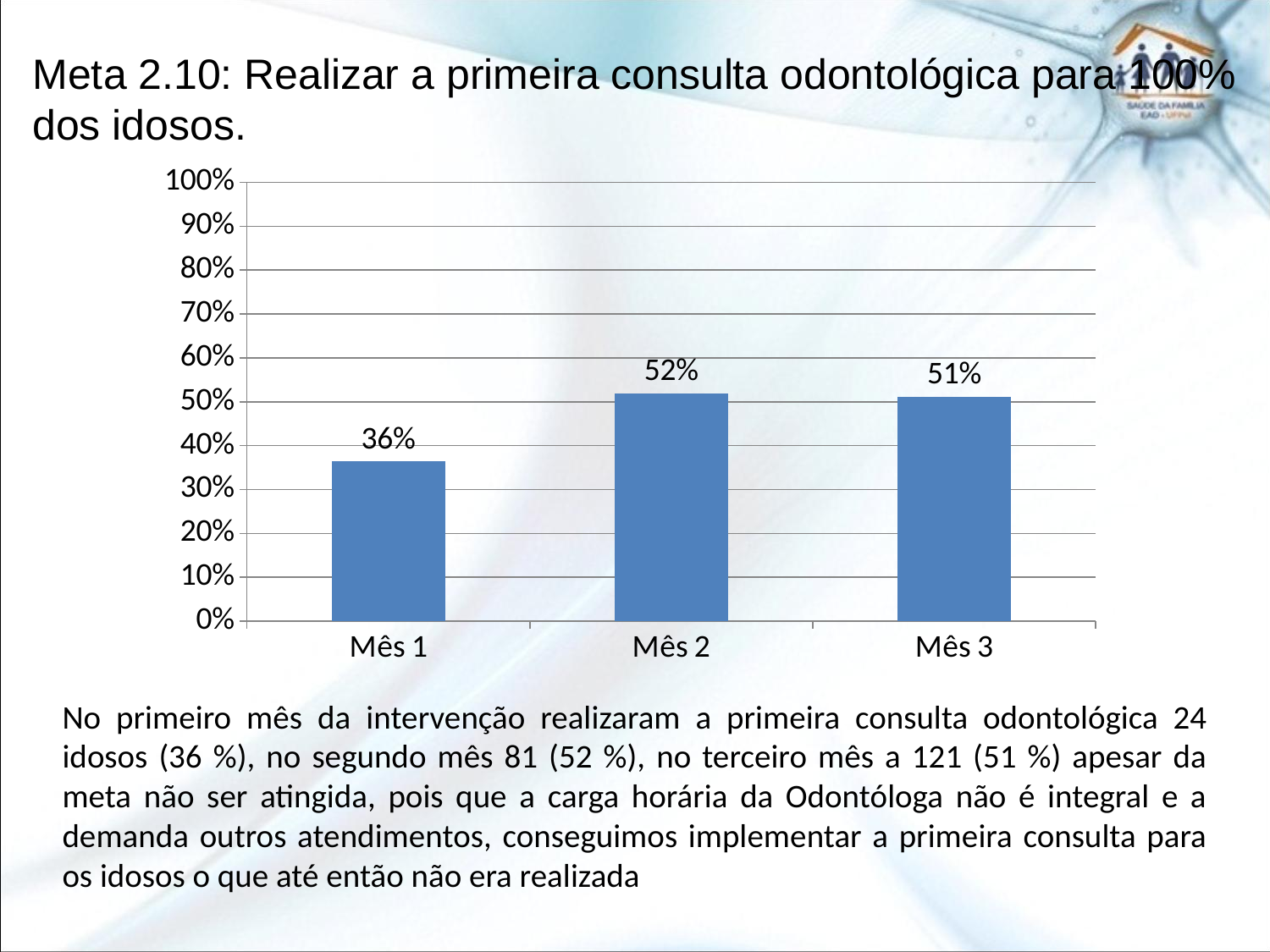
Which month has the lowest value? Mês 1 How many months are shown on the x axis? 3 Which month has the highest value? Mês 2 What is the highest value shown on the y axis? 100% What is the value for Mês 2? 52% What is the difference between the values for Mês 2 and Mês 1? 16% What is the value for Mês 1? 36% Is the value for Mês 1 greater or less than 40%? less What kind of chart is shown on the slide? bar chart What is the difference between the values for Mês 2 and Mês 3? 1% Which is larger, the value for Mês 1 or the value for Mês 3? Mês 3 What is the value for Mês 3? 51%